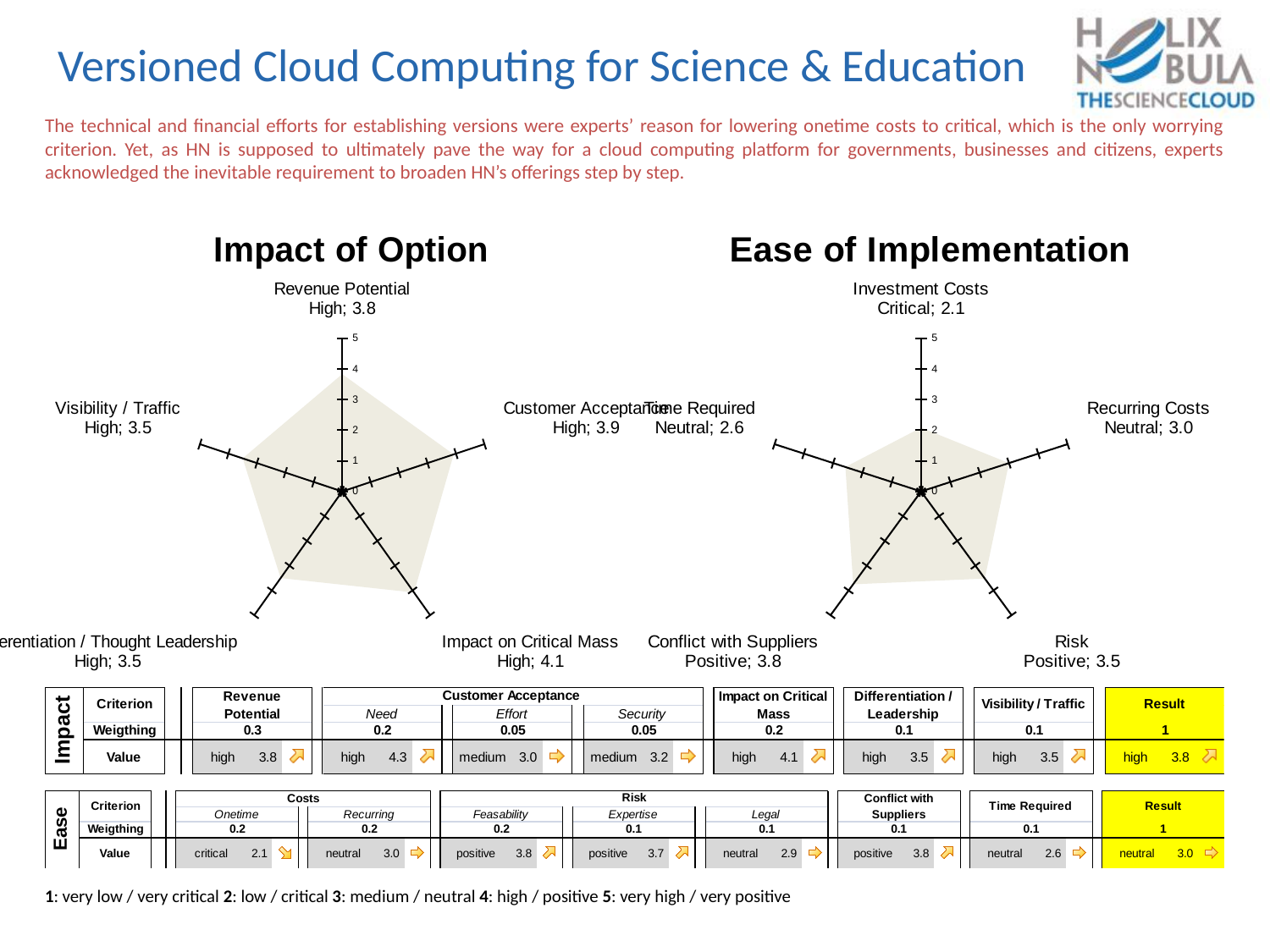
What type of chart is the Impact of Option chart? Radar chart On the Ease of Implementation chart, what is the difference between the values for Recurring Costs and Investment Costs? 0.9 On the Impact of Option chart, what value is shown for Impact on Critical Mass? 4.1 On the Ease of Implementation chart, what value is shown for Investment Costs? 2.1 On the Ease of Implementation chart, which criterion has the highest value? Conflict with Suppliers How many criteria are plotted on the Ease of Implementation chart? 5 On the Impact of Option chart, what value is shown for Revenue Potential? 3.8 On the Impact of Option chart, which criterion has the highest value? Impact on Critical Mass On the Impact of Option chart, what is the difference between the values for Impact on Critical Mass and Visibility / Traffic? 0.6 On the Ease of Implementation chart, which criterion has the lowest value? Investment Costs On the Ease of Implementation chart, what value is shown for Conflict with Suppliers? 3.8 On the Ease of Implementation chart, which is larger: the value for Risk or the value for Time Required? Risk